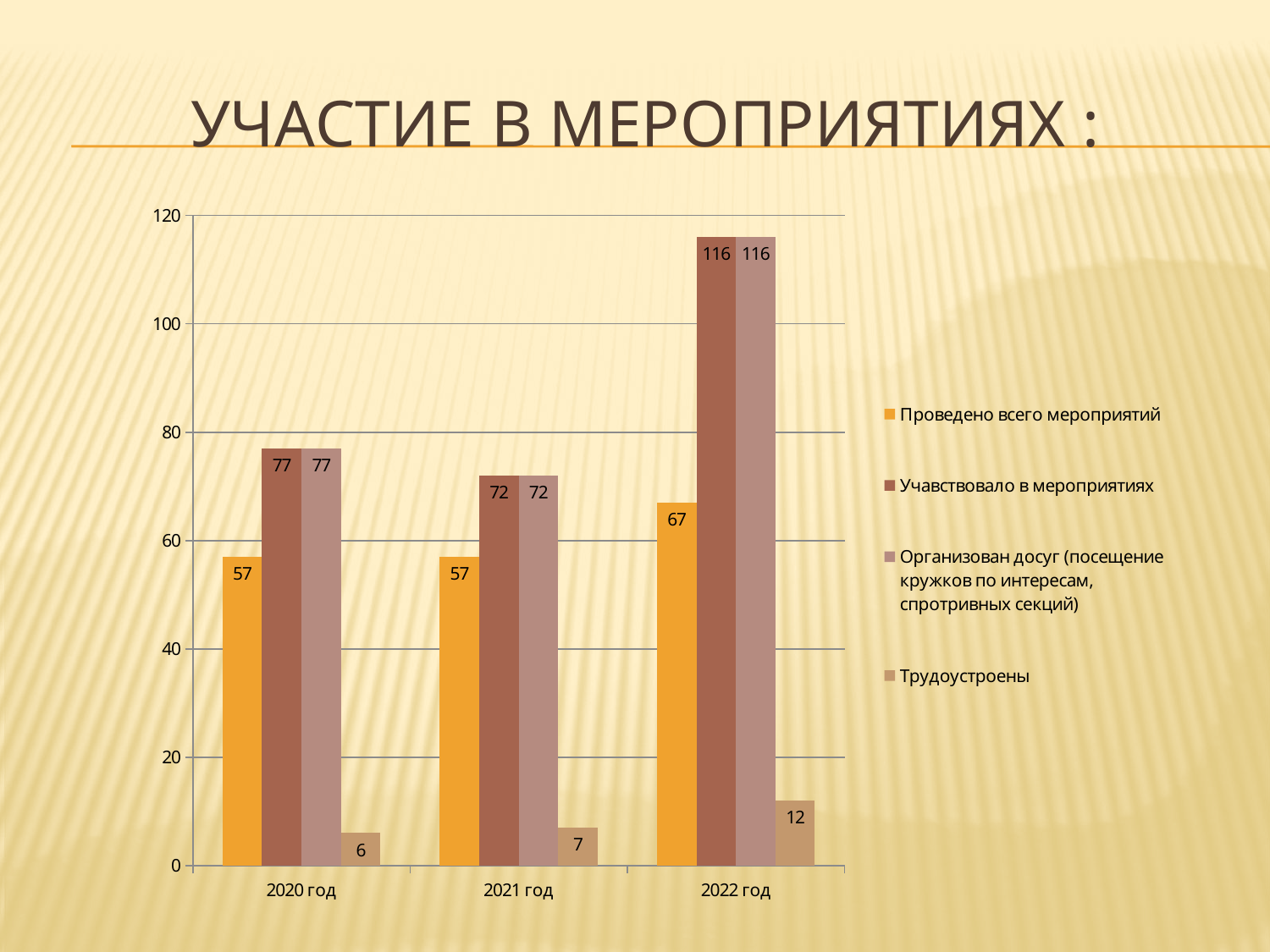
How many series does the legend list? 4 Does the value of 'Трудоустроены' rise or fall from 2020 год to 2022 год? Rise What is the difference between 'Учавствовало в мероприятиях' in 2022 год and in 2021 год? 44 What is the value of 'Учавствовало в мероприятиях' for 2020 год? 77 What is the value of 'Проведено всего мероприятий' for 2022 год? 67 Which is larger: 'Проведено всего мероприятий' in 2022 год or 'Учавствовало в мероприятиях' in 2021 год? Учавствовало в мероприятиях in 2021 год What is the value of 'Трудоустроены' for 2021 год? 7 What kind of chart is shown on the slide? Bar chart What is the title of the slide? УЧАСТИЕ В МЕРОПРИЯТИЯХ : How many years are shown on the x axis? 3 In which year is 'Учавствовало в мероприятиях' highest? 2022 год In which year is 'Трудоустроены' lowest? 2020 год